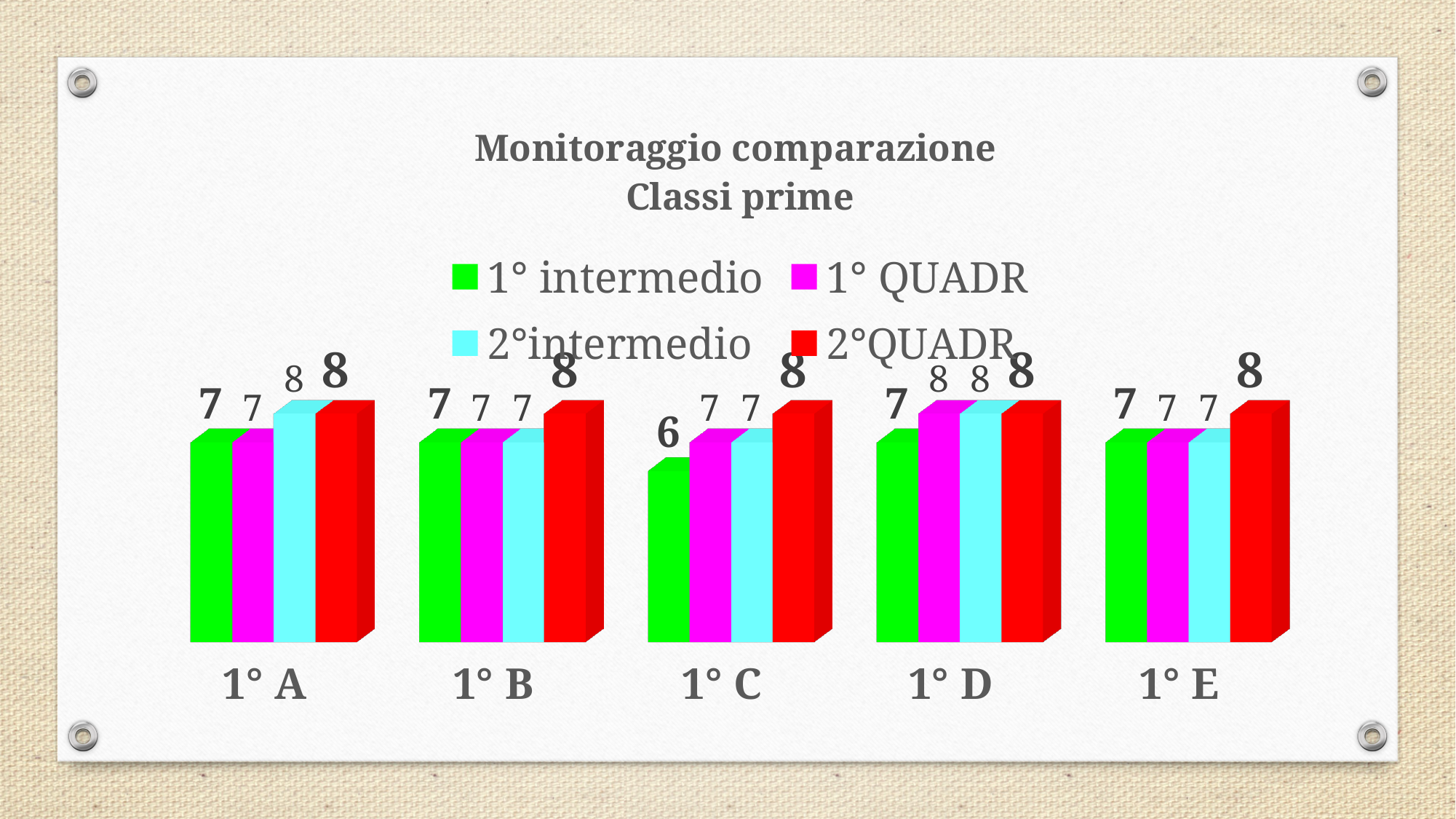
What is the value of 1° QUADR for 1° D? 8 Which is larger for 1° A: the 1° QUADR value or the 2°intermedio value? 2°intermedio How many classes are shown on the x axis? 5 What is the value of 1° intermedio for 1° C? 6 What is the value of 2°QUADR for 1° E? 8 Which class has the highest 1° QUADR value? 1° D Which class has the lowest 1° intermedio value? 1° C How many series does the legend list? 4 What is the title of the chart? Monitoraggio comparazione Classi prime What is the difference between the 2°QUADR and 1° intermedio values for 1° C? 2 What is the value of 2°intermedio for 1° A? 8 What kind of chart is shown on the slide? Bar chart